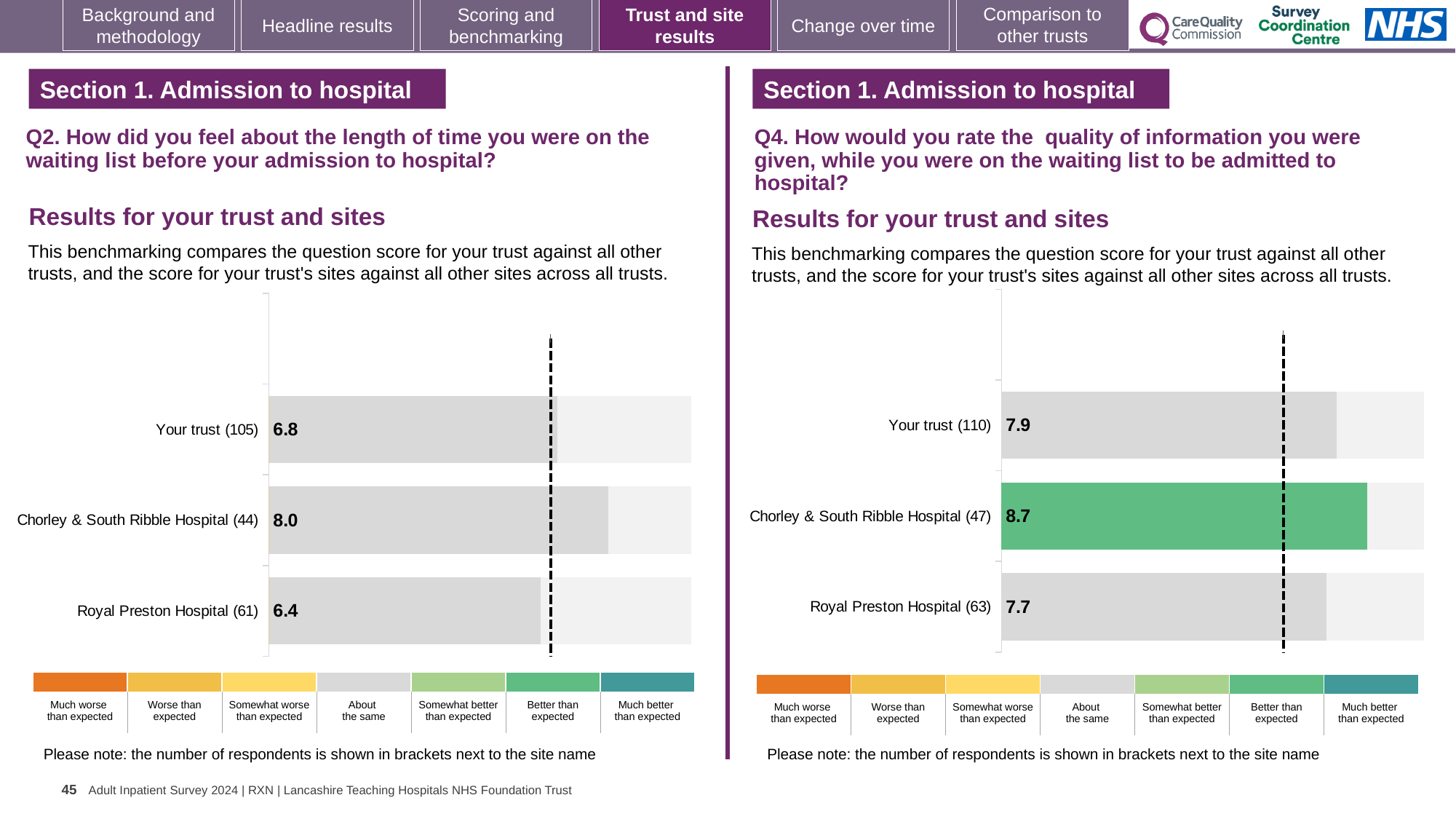
In the Q2 chart on the left, what is the score for Royal Preston Hospital? 6.4 In the Q4 chart on the right, what is the score for Your trust? 7.9 In the Q4 chart on the right, what is the difference between the scores for Chorley & South Ribble Hospital and Your trust? 0.8 In the Q2 chart on the left, how many respondents are shown in brackets for Chorley & South Ribble Hospital? 44 In the Q4 chart on the right, what is the score for Chorley & South Ribble Hospital? 8.7 In the Q4 chart on the right, which has a higher score: Your trust or Royal Preston Hospital? Your trust What type of chart is used in the Q4 chart on the right? Bar chart In the Q2 chart on the left, what is the score for Your trust? 6.8 In the Q4 chart on the right, which site or trust has the lowest score? Royal Preston Hospital How many bars are plotted in the Q2 chart on the left? 3 In the Q2 chart on the left, which site or trust has the highest score? Chorley & South Ribble Hospital In the Q2 chart on the left, what is the difference between the scores for Chorley & South Ribble Hospital and Royal Preston Hospital? 1.6